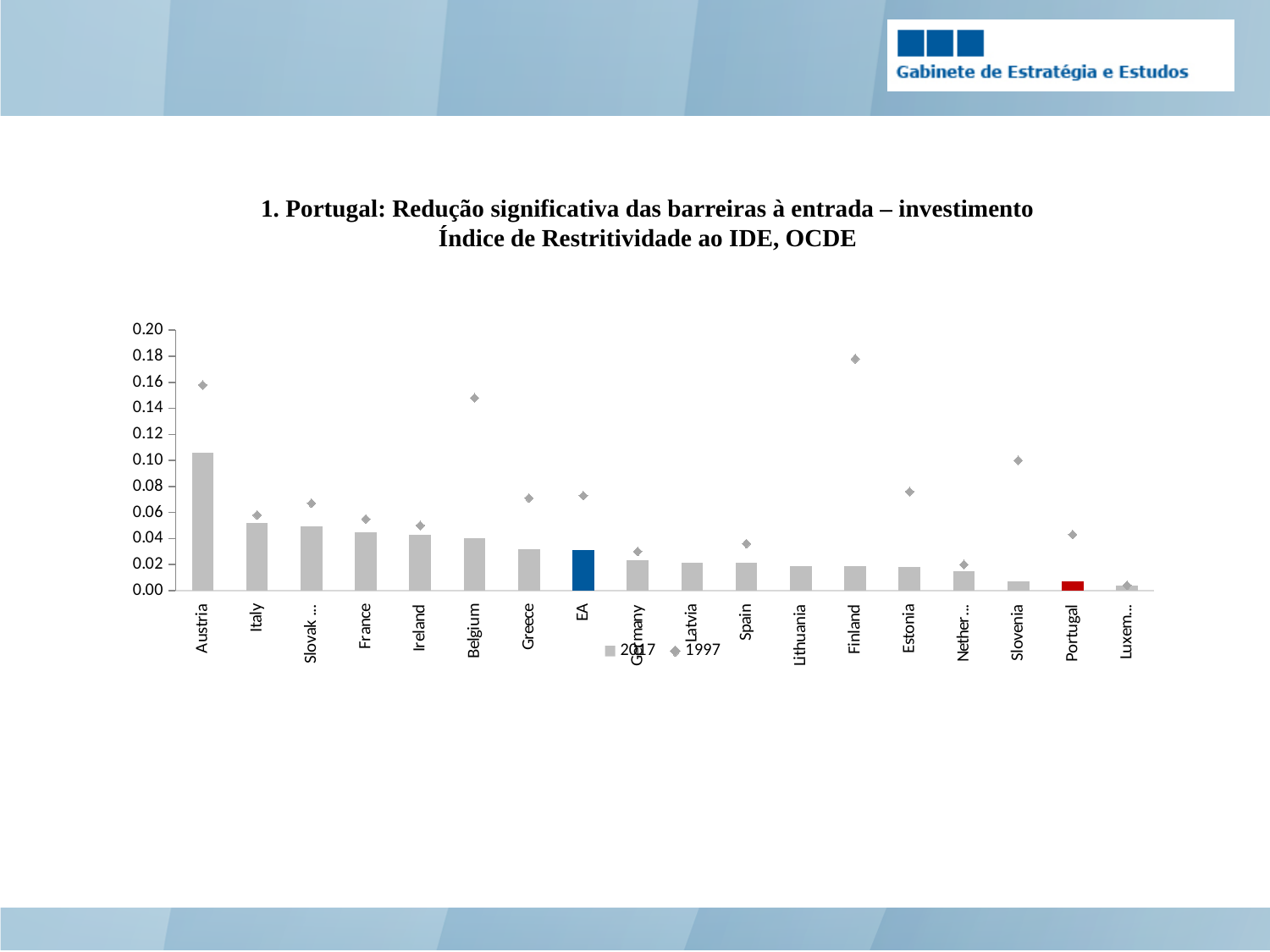
For Portugal, which is larger, the 1997 value or the 2017 value? 1997 Is the 1997 value for Finland greater or less than 0.16? greater Is the 2017 value for Austria greater or less than 0.08? greater Which category's bar is coloured red? Portugal Which category has the highest 2017 bar? Austria How many countries/categories are shown on the x axis? 18 Which is larger, the 2017 value for Austria or the 2017 value for Italy? Austria How many series does the legend list? 2 Do the 2017 bars generally rise or fall from left to right along the x axis? fall What kind of chart is shown on the slide? A bar chart with diamond markers (combined bar and scatter chart) Which category has the highest 1997 value (diamond marker)? Finland Is the 2017 value for Portugal greater or less than 0.02? less